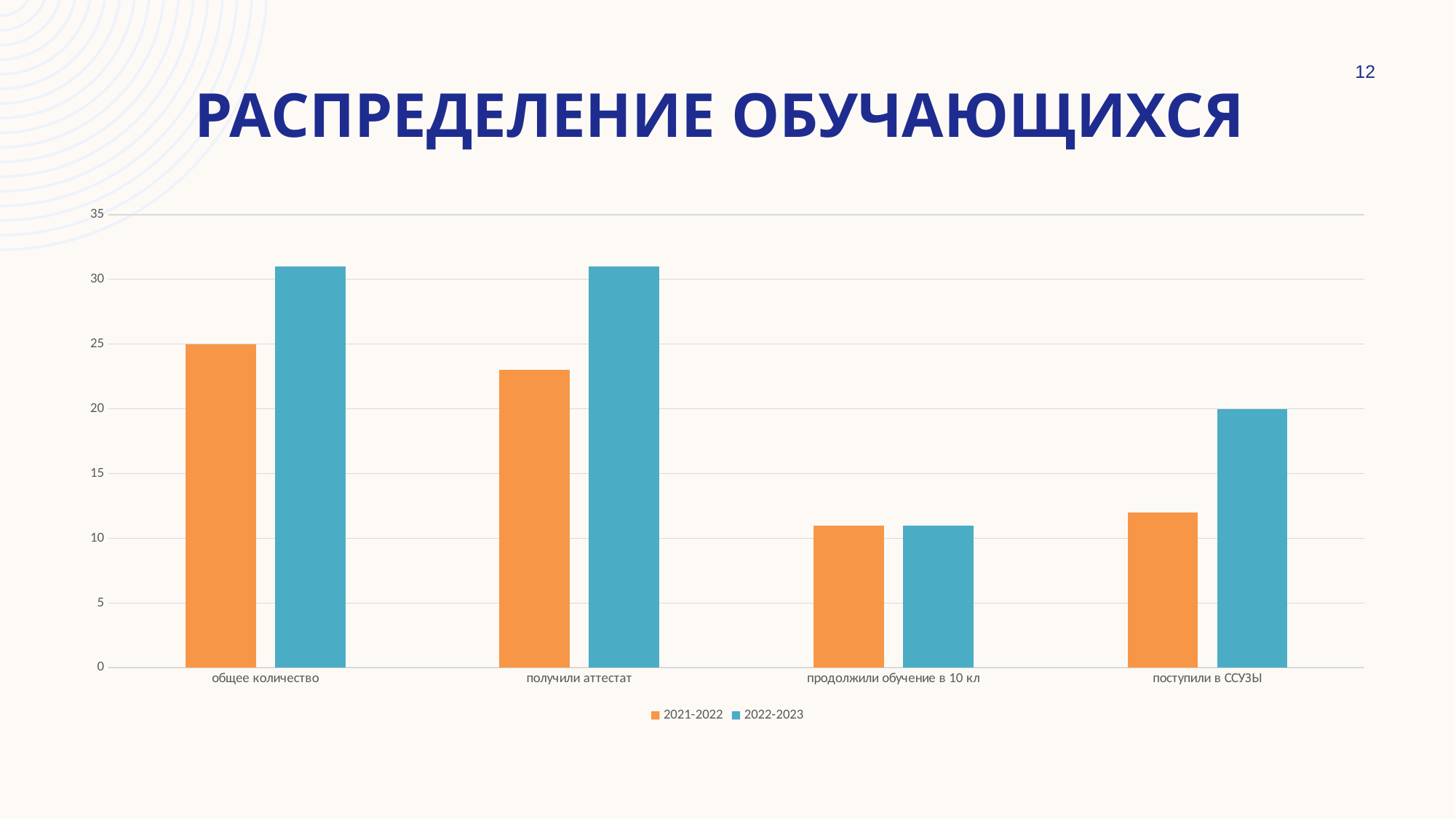
How many series does the legend list? 2 Which category has the lowest value in the 2022-2023 series? продолжили обучение в 10 кл Is the value for общее количество in the 2022-2023 series greater or less than 30? greater Which is larger for общее количество: the 2021-2022 value or the 2022-2023 value? 2022-2023 Is the value for продолжили обучение в 10 кл in the 2022-2023 series greater or less than 15? less What is the value for поступили в ССУЗЫ in the 2022-2023 series? 20 What is the title of the chart slide? РАСПРЕДЕЛЕНИЕ ОБУЧАЮЩИХСЯ What kind of chart is shown on the slide? bar chart What is the value for общее количество in the 2021-2022 series? 25 How many categories are shown on the x axis? 4 Which series is shown in orange? 2021-2022 Is the value for получили аттестат in the 2021-2022 series greater or less than 25? less